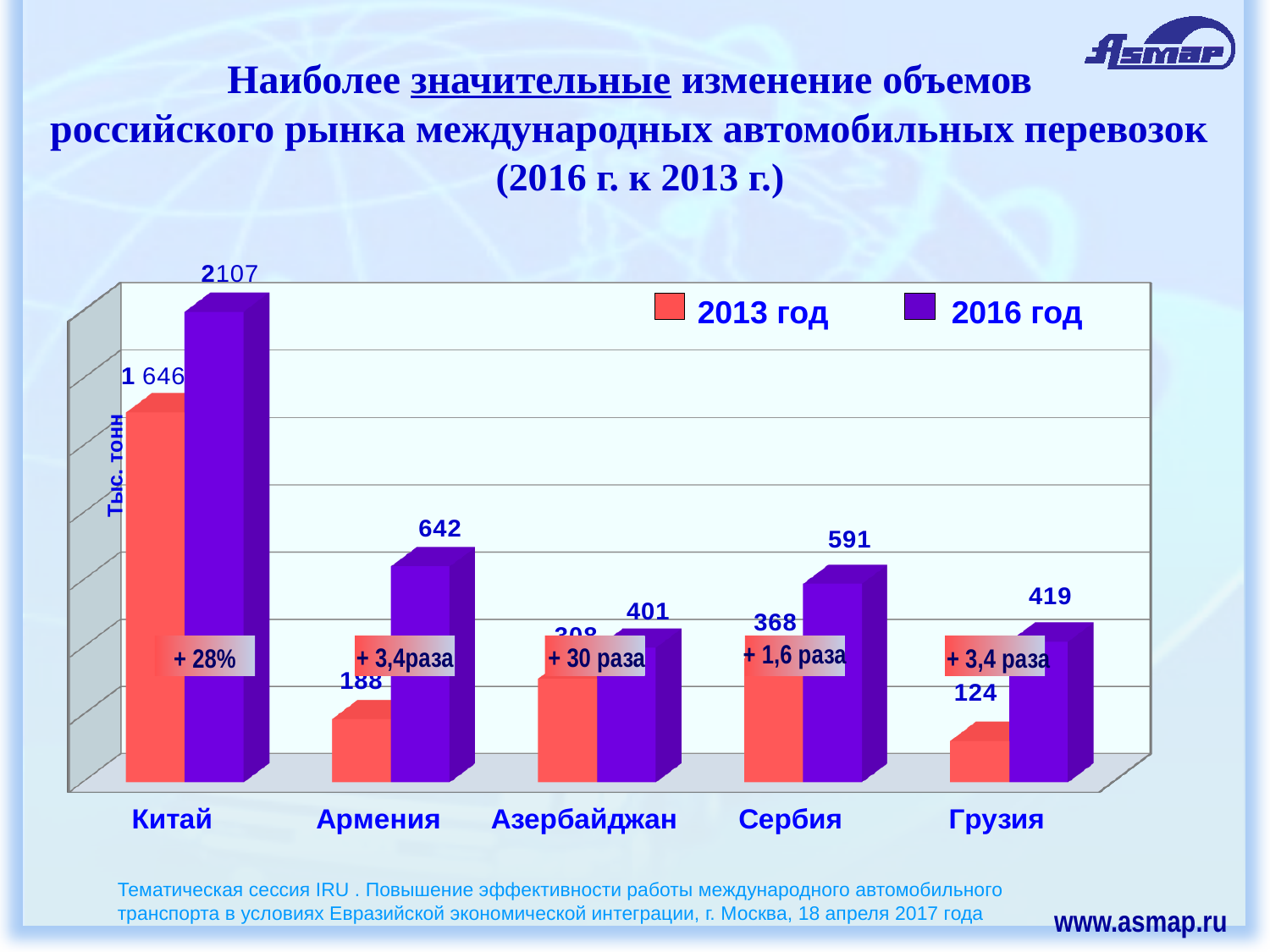
What is the value for Китай in 2016 год? 2107 How many series does the legend list? 2 Which country has the highest value in 2016 год? Китай What is the value for Грузия in 2013 год? 124 What unit is given on the vertical axis label? тыс. тонн Which is larger: the 2016 год value for Армения or the 2016 год value for Сербия? Армения Which country has the lowest value in 2013 год? Грузия How many countries are shown on the x axis? 5 What is the value for Китай in 2013 год? 1 646 What is the difference between the 2016 год and 2013 год values for Сербия? 223 What kind of chart is shown on the slide? bar chart What is the value for Армения in 2016 год? 642